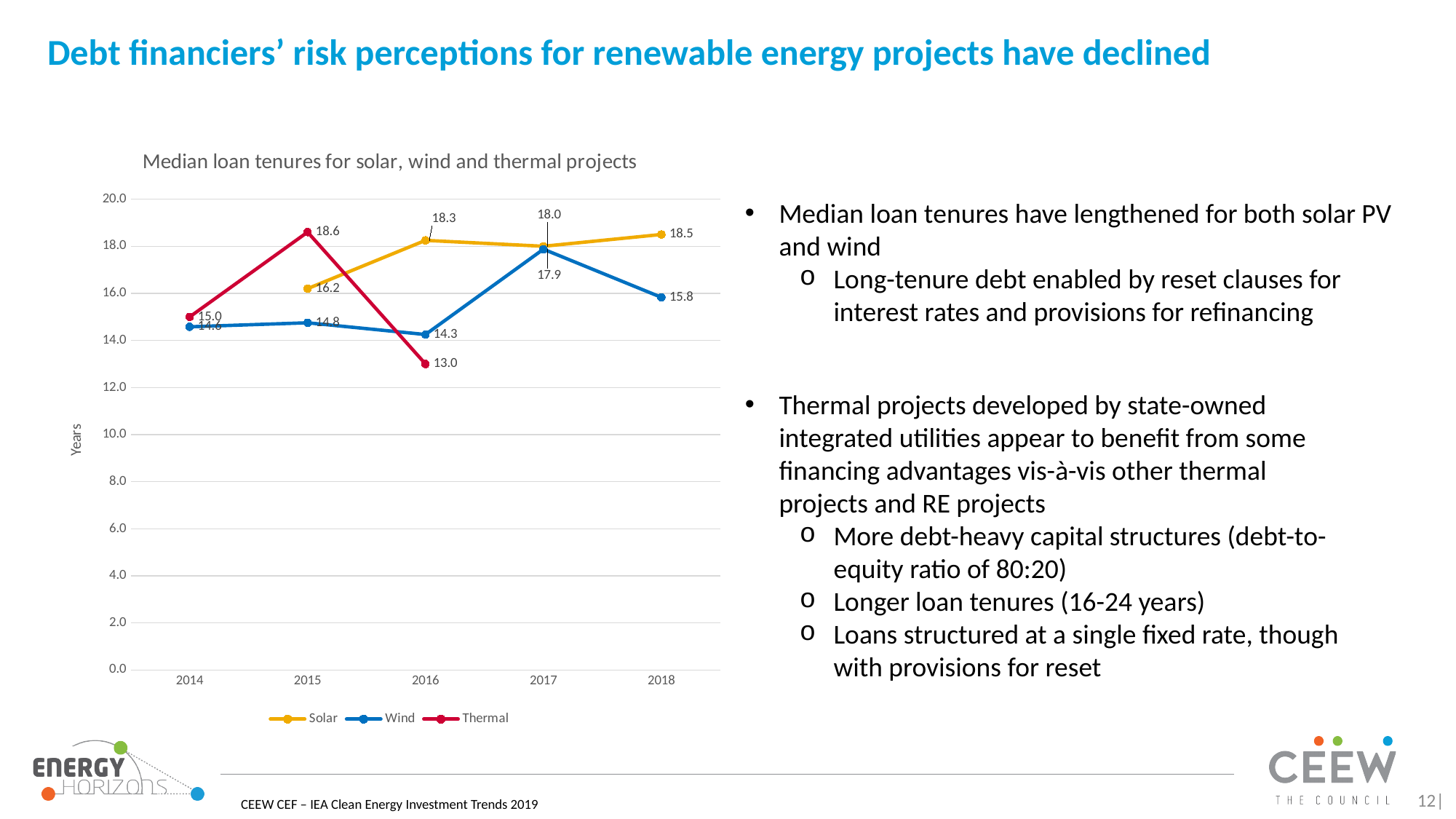
What is the median loan tenure for Thermal in 2015? 18.6 How many years are shown on the x axis? 5 What kind of chart is shown on the slide? Line chart What is the difference between the Solar values for 2018 and 2015? 2.3 What is the median loan tenure for Solar in 2018? 18.5 How many series does the legend list? 3 Is the Thermal value for 2016 greater or less than 14.0? less In which year is the Solar series at its lowest? 2015 In which year is the Thermal series at its highest? 2015 What is the label on the y axis? Years What is the median loan tenure for Wind in 2017? 17.9 Which series has the larger value in 2018, Solar or Wind? Solar